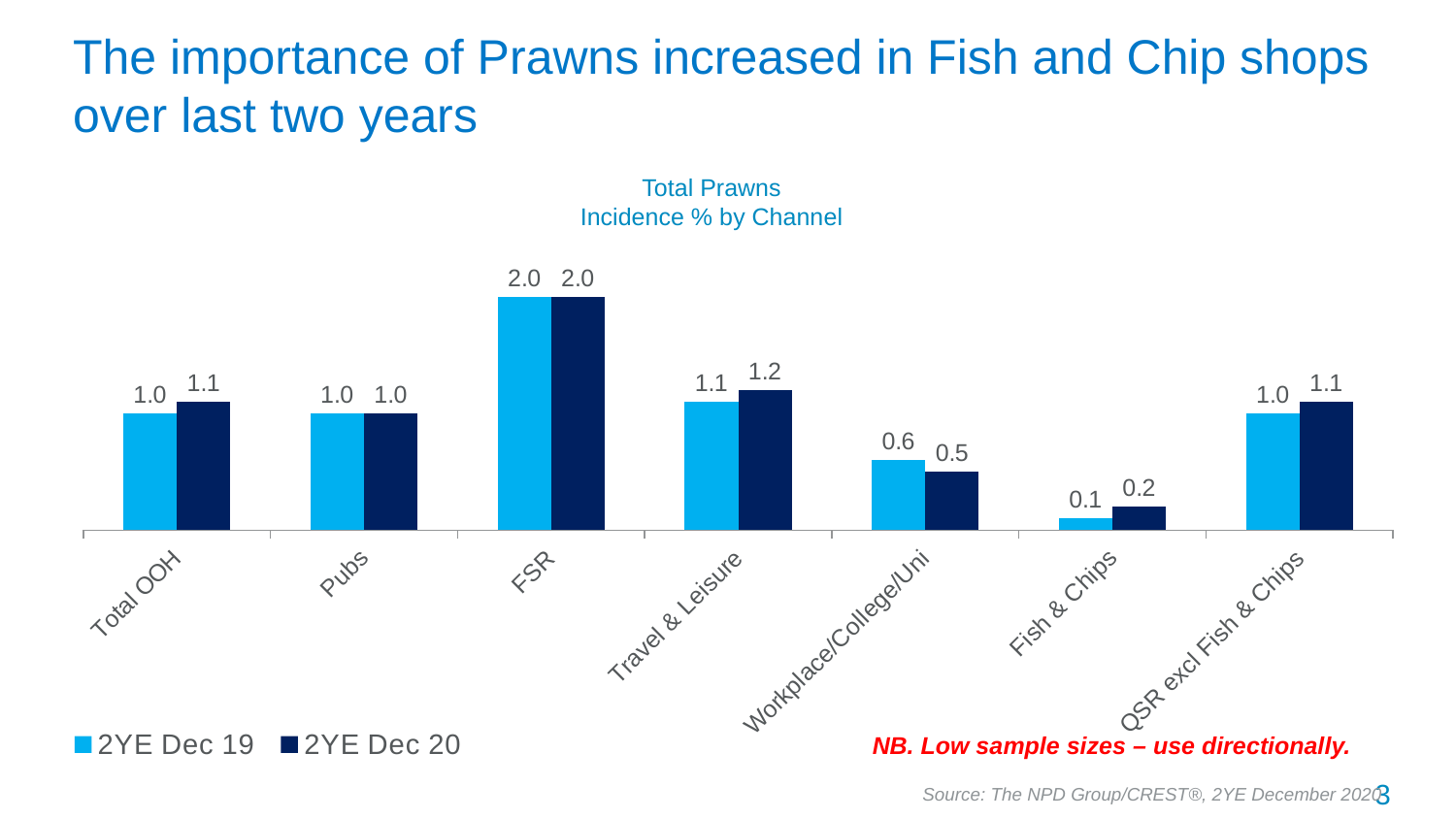
For Workplace/College/Uni, which series has the larger value, 2YE Dec 19 or 2YE Dec 20? 2YE Dec 19 What is the value for Workplace/College/Uni in the 2YE Dec 20 series? 0.5 How many series does the legend list? 2 What is the value for FSR in the 2YE Dec 20 series? 2.0 What is the difference between the FSR and Pubs values in the 2YE Dec 19 series? 1.0 What is the value for Fish & Chips in the 2YE Dec 19 series? 0.1 What is the title of the chart? Total Prawns Incidence % by Channel How many channels are shown on the x axis? 7 What kind of chart is shown on the slide? Bar chart Which channel has the highest value in the 2YE Dec 20 series? FSR What is the difference between the 2YE Dec 20 and 2YE Dec 19 values for Travel & Leisure? 0.1 Which channel has the lowest value in the 2YE Dec 19 series? Fish & Chips